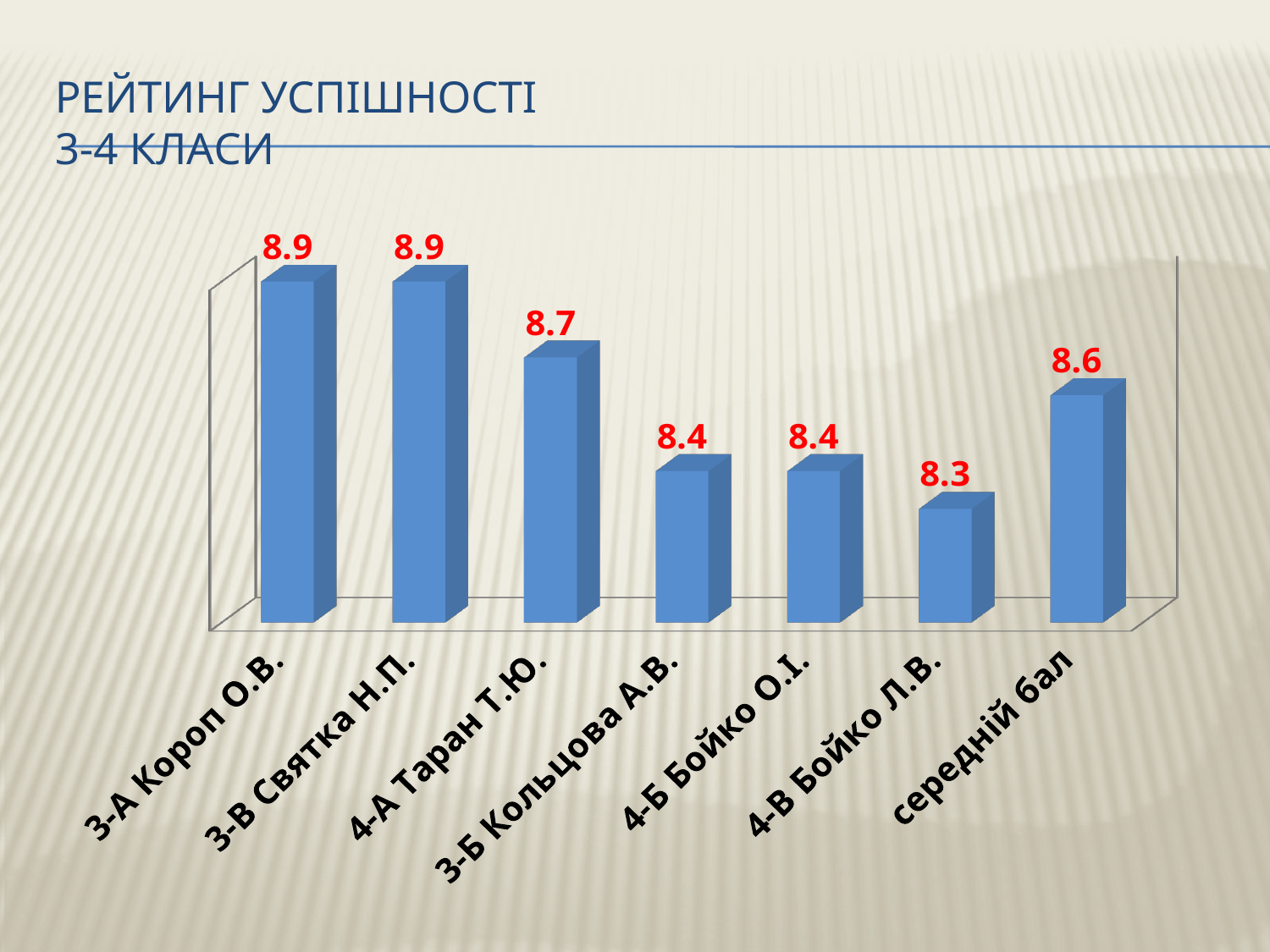
What value is shown for 4-В Бойко Л.В.? 8.3 What is the value of the середній бал bar? 8.6 What is the difference between the values for 4-А Таран Т.Ю. and 3-Б Кольцова А.В.? 0.3 What is the difference between the values for 3-В Святка Н.П. and 4-В Бойко Л.В.? 0.6 Which is larger: the value for 4-А Таран Т.Ю. or the value for 4-Б Бойко О.І.? 4-А Таран Т.Ю. Which is larger: the value for середній бал or the value for 4-В Бойко Л.В.? середній бал What value is shown for 4-А Таран Т.Ю.? 8.7 How many bars are shown in the chart? 7 What is the title of the slide? Рейтинг успішності 3-4 класи What value is shown for 3-А Короп О.В.? 8.9 What kind of chart is shown on the slide? bar chart Which category has the lowest value? 4-В Бойко Л.В.